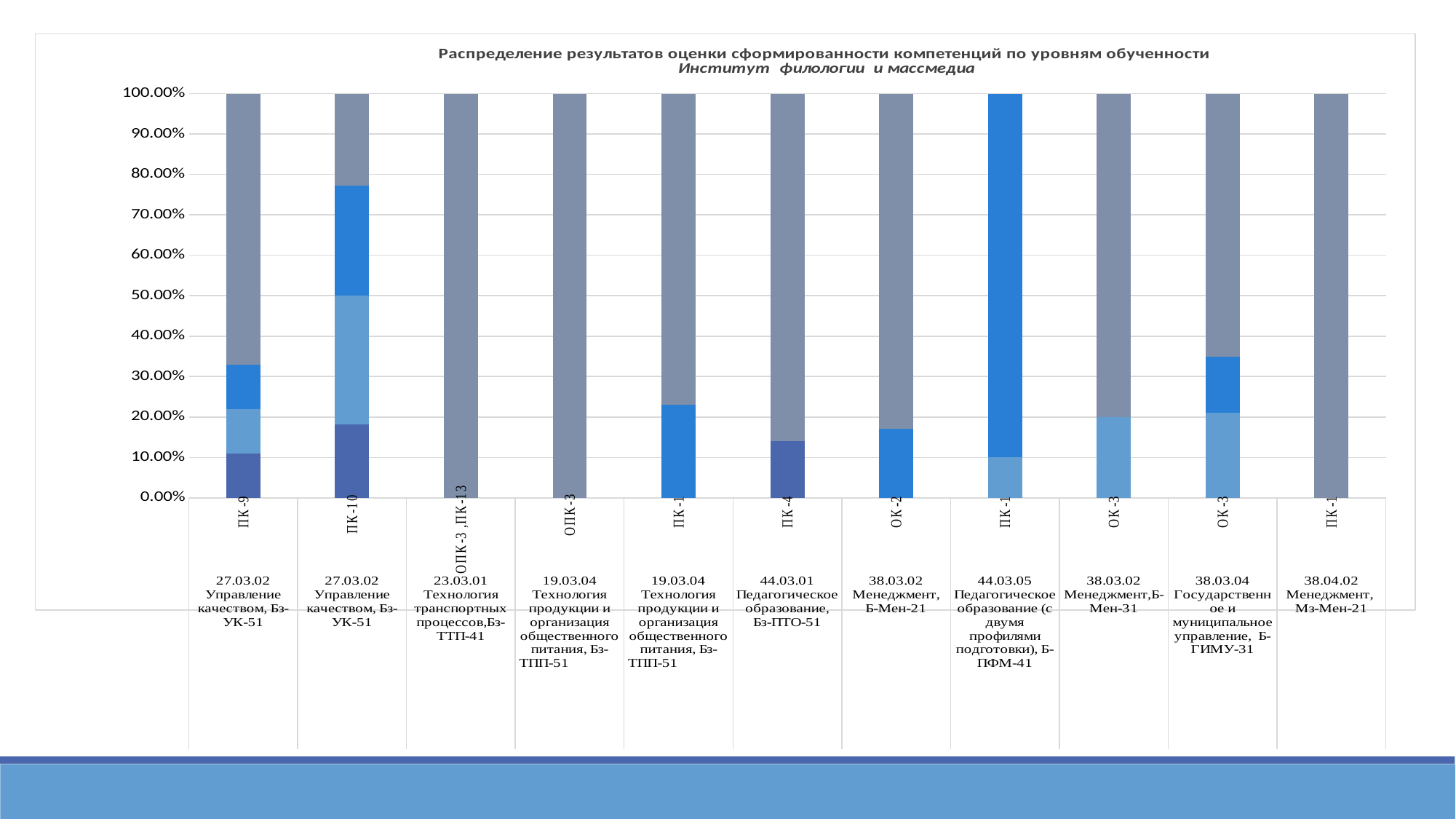
Which bar has no gray segment at all? ПК-1 (44.03.05 Педагогическое образование (с двумя профилями подготовки), Б-ПФМ-41) Is the top of the bright blue segment for ПК-10 (27.03.02 Управление качеством, Бз-УК-51) greater or less than 70%? greater Which bar has the largest bright blue segment? ПК-1 (44.03.05 Педагогическое образование (с двумя профилями подготовки), Б-ПФМ-41) What kind of chart is shown on the slide? Stacked bar chart Is the top of the dark navy segment for ПК-4 (44.03.01 Педагогическое образование, Бз-ПТО-51) greater or less than 20%? less How many bars consist entirely of the gray segment? 3 Which institute is named in the chart's subtitle? Институт филологии и массмедиа How many bars (competency categories) are plotted on the chart? 11 Is the top of the bright blue segment for ПК-1 (19.03.04 Технология продукции и организация общественного питания, Бз-ТПП-51) greater or less than 30%? less Is the dark navy bottom segment larger for ПК-9 or for ПК-10 (both 27.03.02 Управление качеством, Бз-УК-51)? ПК-10 What is the first line of the chart title? Распределение результатов оценки сформированности компетенций по уровням обученности